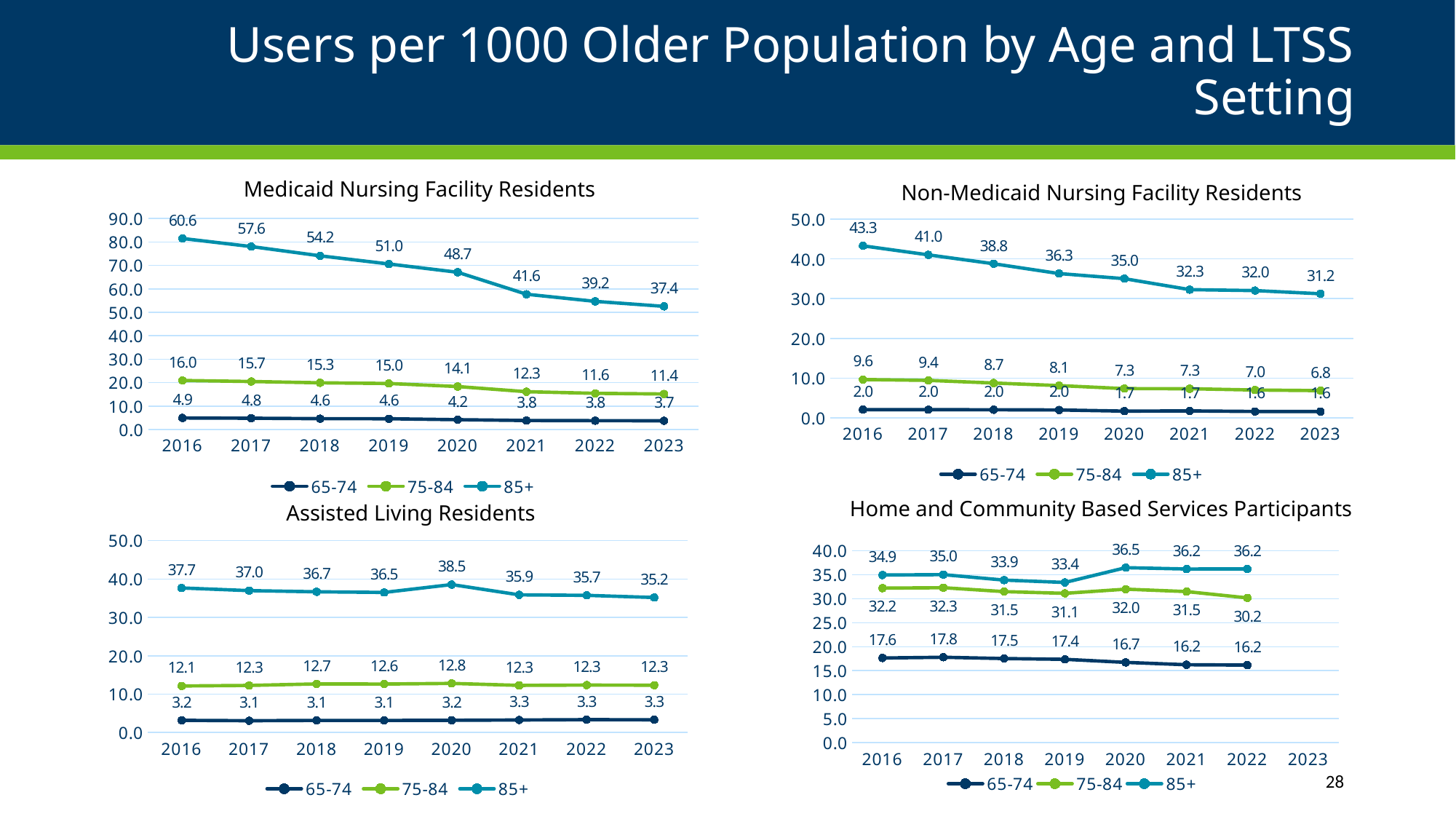
In the Non-Medicaid Nursing Facility Residents chart, does the 85+ series rise or fall from 2016 to 2023? fall In the Home and Community Based Services Participants chart, what is the value for the 65-74 series in 2017? 17.8 In the Assisted Living Residents chart, in which year is the 85+ series highest? 2020 In the Home and Community Based Services Participants chart, which is larger in 2022: the 85+ value or the 75-84 value? 85+ In the Assisted Living Residents chart, what is the value for the 75-84 series in 2020? 12.8 How many series does the legend list in the Assisted Living Residents chart? 3 In the Medicaid Nursing Facility Residents chart, what is the value for the 85+ series in 2016? 60.6 In the Non-Medicaid Nursing Facility Residents chart, what is the value for the 75-84 series in 2019? 8.1 What kind of chart is the Home and Community Based Services Participants chart? line chart In the Medicaid Nursing Facility Residents chart, what is the difference between the 85+ values in 2016 and 2023? 23.2 In the Medicaid Nursing Facility Residents chart, what is the value for the 65-74 series in 2023? 3.7 In the Non-Medicaid Nursing Facility Residents chart, in which year is the 85+ series lowest? 2023